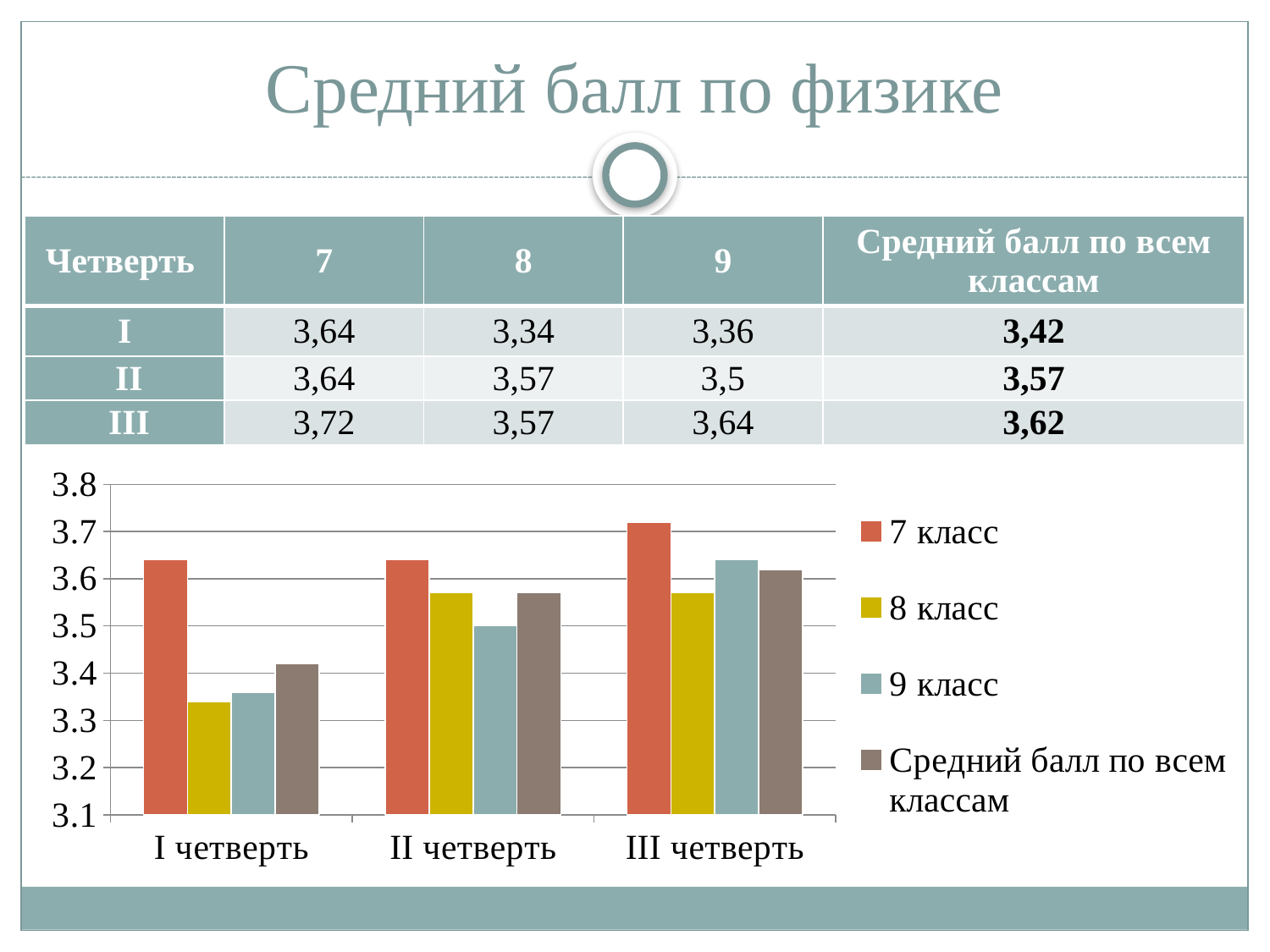
What is the value for 7 класс in I четверть? 3,64 Which series has the highest bar in III четверть? 7 класс What kind of chart is shown on the slide? bar chart Which is larger in I четверть: 7 класс or 8 класс? 7 класс What is the difference between 7 класс and 8 класс in III четверть? 0,15 Does Средний балл по всем классам rise or fall from I четверть to III четверть? rise What is the value of Средний балл по всем классам in II четверть? 3,57 How many quarter categories are shown on the x axis of the chart? 3 Is the value for 9 класс in I четверть greater or less than 3.4? less Which series has the lowest bar in II четверть? 9 класс What is the value for 9 класс in III четверть? 3,64 How many series does the chart legend list? 4